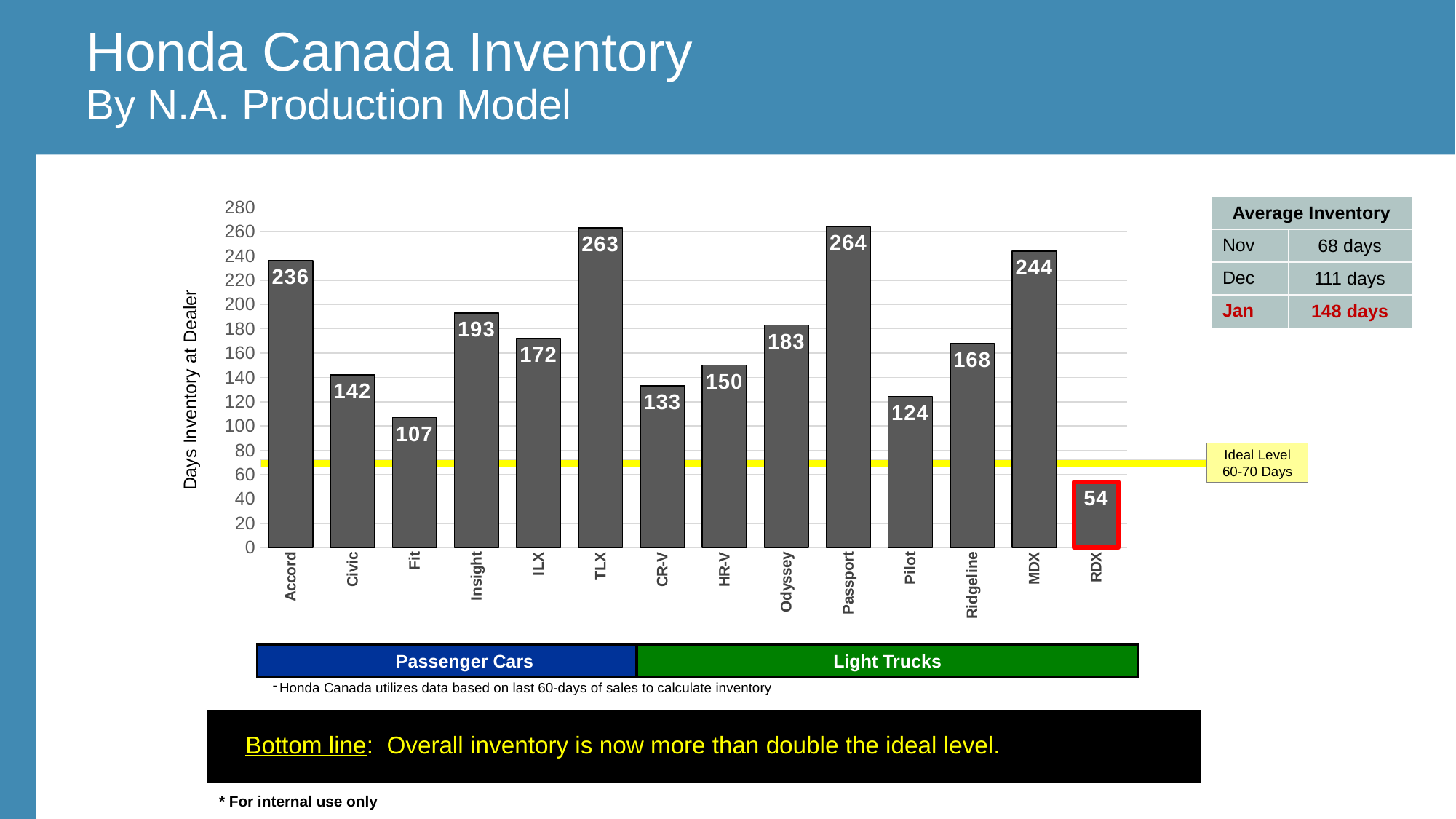
What is the days inventory at dealer for the Accord? 236 What range does the yellow line on the chart mark as the ideal level? 60-70 Days Which has more days inventory at dealer, the Insight or the ILX? Insight What kind of chart is shown on the slide? Bar chart Which model has the lowest days inventory at dealer? RDX What is the days inventory at dealer for the Odyssey? 183 What is the label of the vertical axis of the chart? Days Inventory at Dealer Which has more days inventory at dealer, the Pilot or the Ridgeline? Ridgeline What is the days inventory at dealer for the RDX? 54 Which model has the highest days inventory at dealer? Passport What is the difference in days inventory between the TLX and the Civic? 121 How many models are shown on the chart? 14